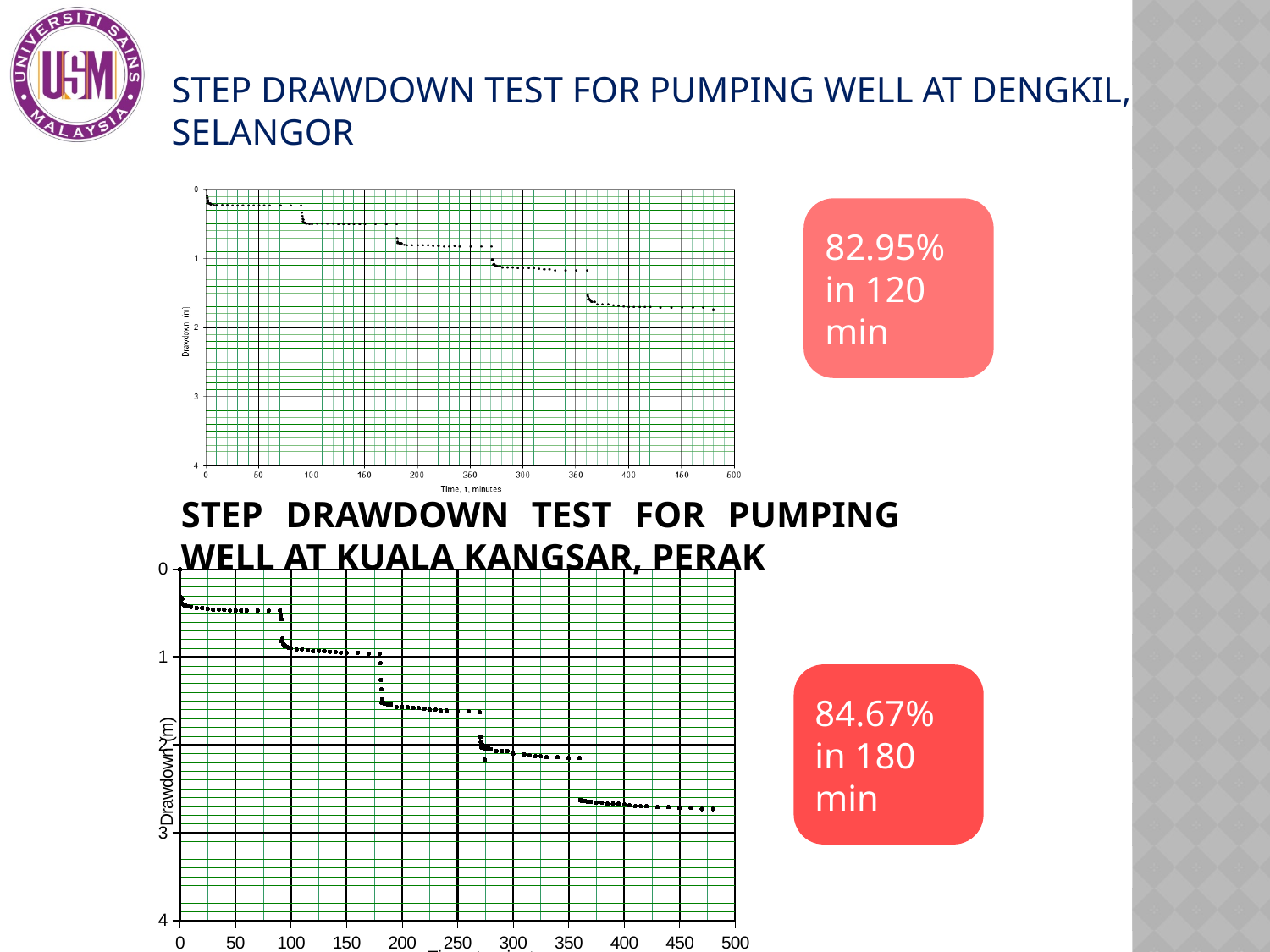
In the bottom chart (Kuala Kangsar, Perak), is the drawdown at 450 minutes greater or less than 3 m? less How many distinct drawdown steps (plateaus) are shown in the bottom chart (Kuala Kangsar, Perak)? 5 What kind of chart is the top chart (Dengkil, Selangor)? scatter chart In the bottom chart (Kuala Kangsar, Perak), is the drawdown at 450 minutes greater or less than 2 m? greater In the top chart (Dengkil, Selangor), is the drawdown at 400 minutes greater or less than 2 m? less What is the label of the x axis in the top chart (Dengkil, Selangor)? Time, t, minutes What is the maximum value shown on the y axis of the bottom chart (Kuala Kangsar, Perak)? 4 At 450 minutes, which chart shows the larger drawdown, the top chart (Dengkil) or the bottom chart (Kuala Kangsar)? bottom chart (Kuala Kangsar) In the top chart (Dengkil, Selangor), does the drawdown rise or fall as time increases? rise What kind of chart is the bottom chart (Kuala Kangsar, Perak)? scatter chart In the bottom chart (Kuala Kangsar, Perak), does the drawdown rise or fall as time increases? rise